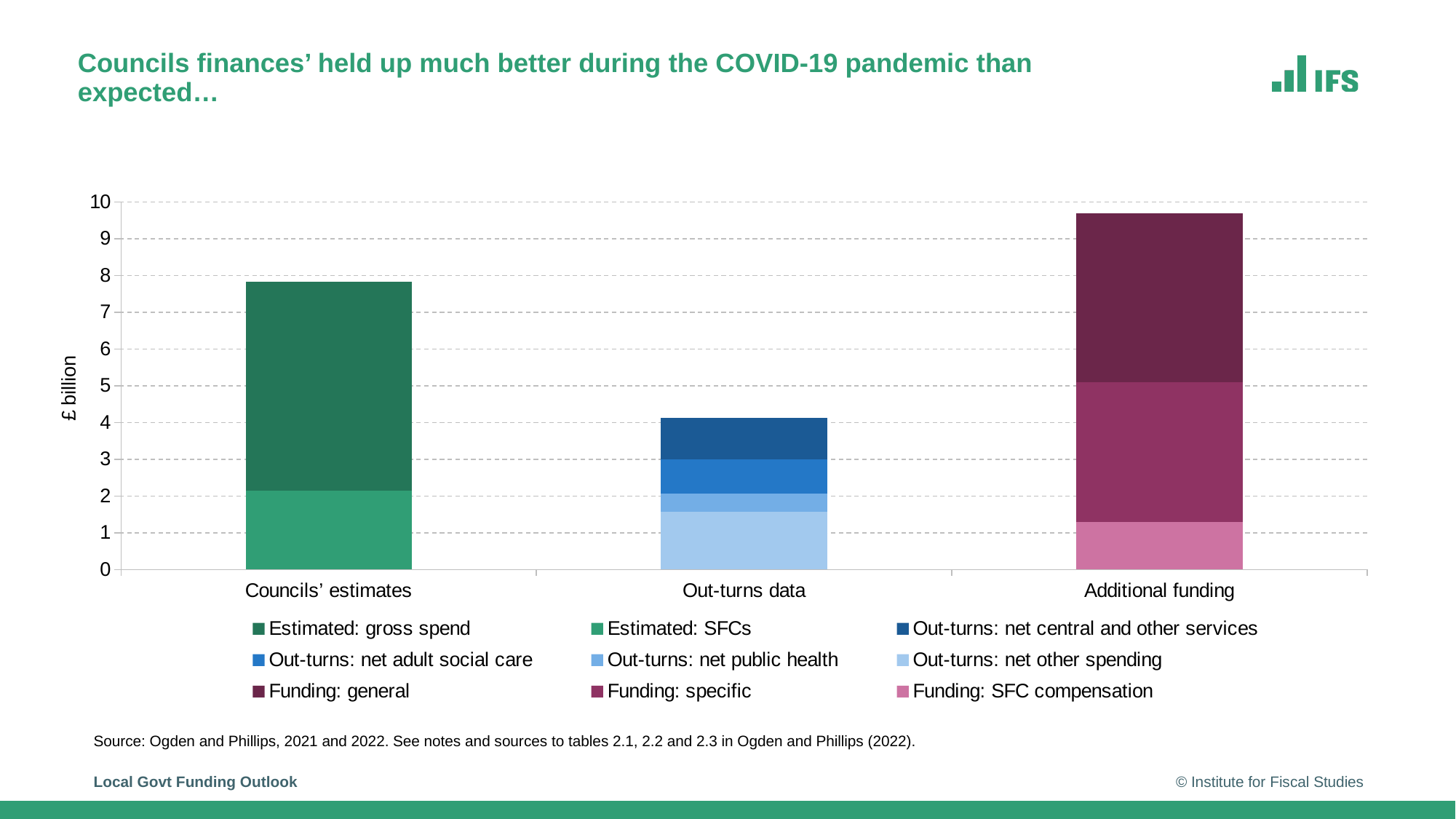
How many series does the legend list? 9 Is the total stacked bar for Out-turns data greater or less than 5? less Is the total stacked bar for Councils' estimates greater or less than 7? greater What kind of chart is shown on the slide? stacked bar chart How many categories are shown on the x axis? 3 Is the Funding: SFC compensation segment in the Additional funding bar greater or less than 1? greater Which category has the tallest stacked bar? Additional funding Which is larger, the total for Councils' estimates or the total for Out-turns data? Councils' estimates What is the label on the vertical axis? £ billion Which legend entry is shown in the lightest blue colour? Out-turns: net other spending Which category has the shortest stacked bar? Out-turns data